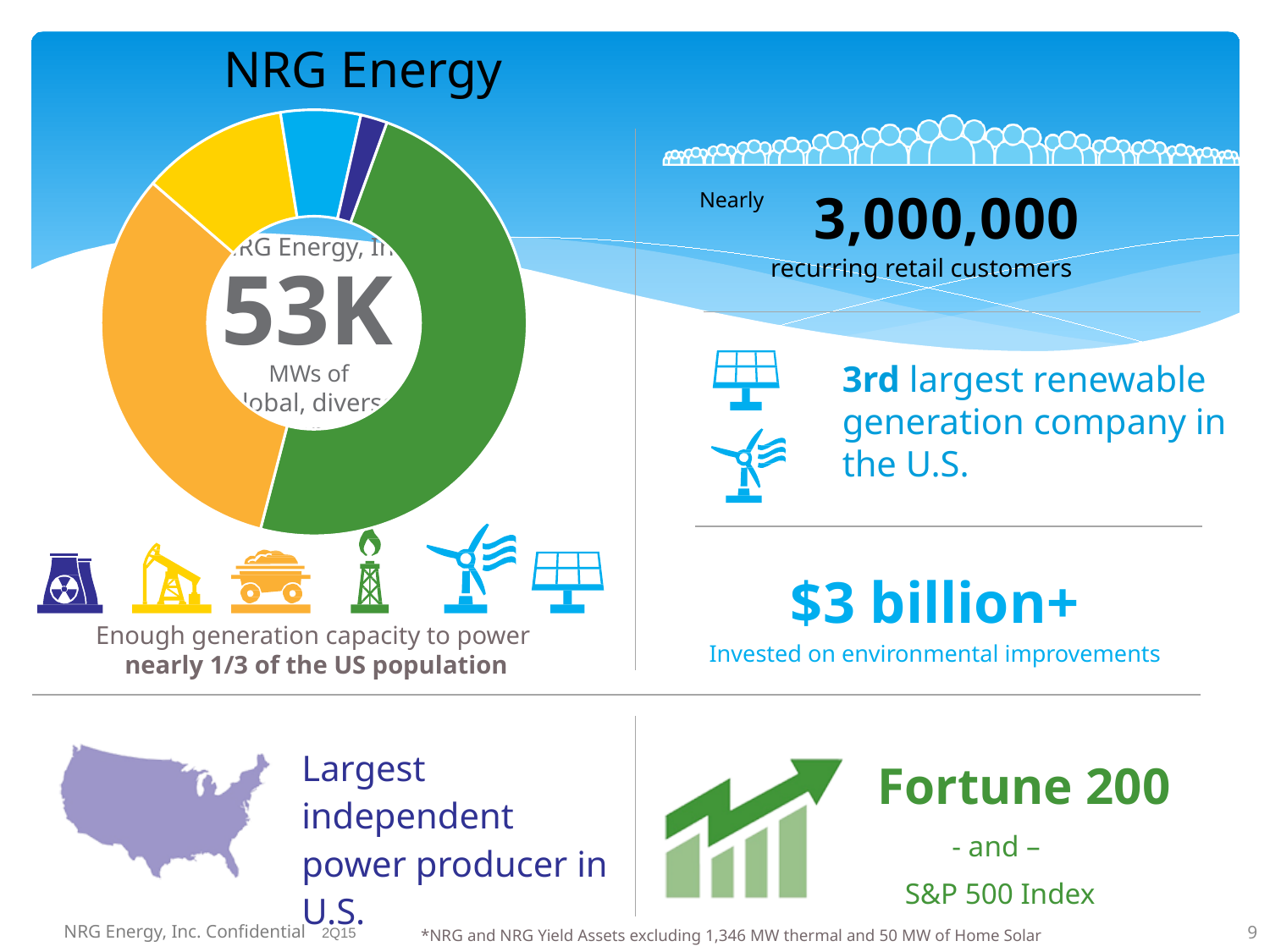
In the pie chart on the left of the slide, which slice is larger, the orange one or the yellow one? orange In the pie chart on the left of the slide, which slice is larger, the yellow one or the light blue one? yellow Which colour slice is the largest in the pie chart on the left of the slide? green What unit is printed directly below the 53K value in the centre of the pie chart? MWs What is the title shown above the pie chart on the left of the slide? NRG Energy Which colour slice is the smallest in the pie chart on the left of the slide? dark blue In the pie chart on the left of the slide, which slice is larger, the green one or the orange one? green What large value is printed in the centre of the pie chart on the left of the slide? 53K How many slices does the pie chart on the left of the slide have? 5 What kind of chart is shown on the left of the slide under the title NRG Energy? doughnut chart